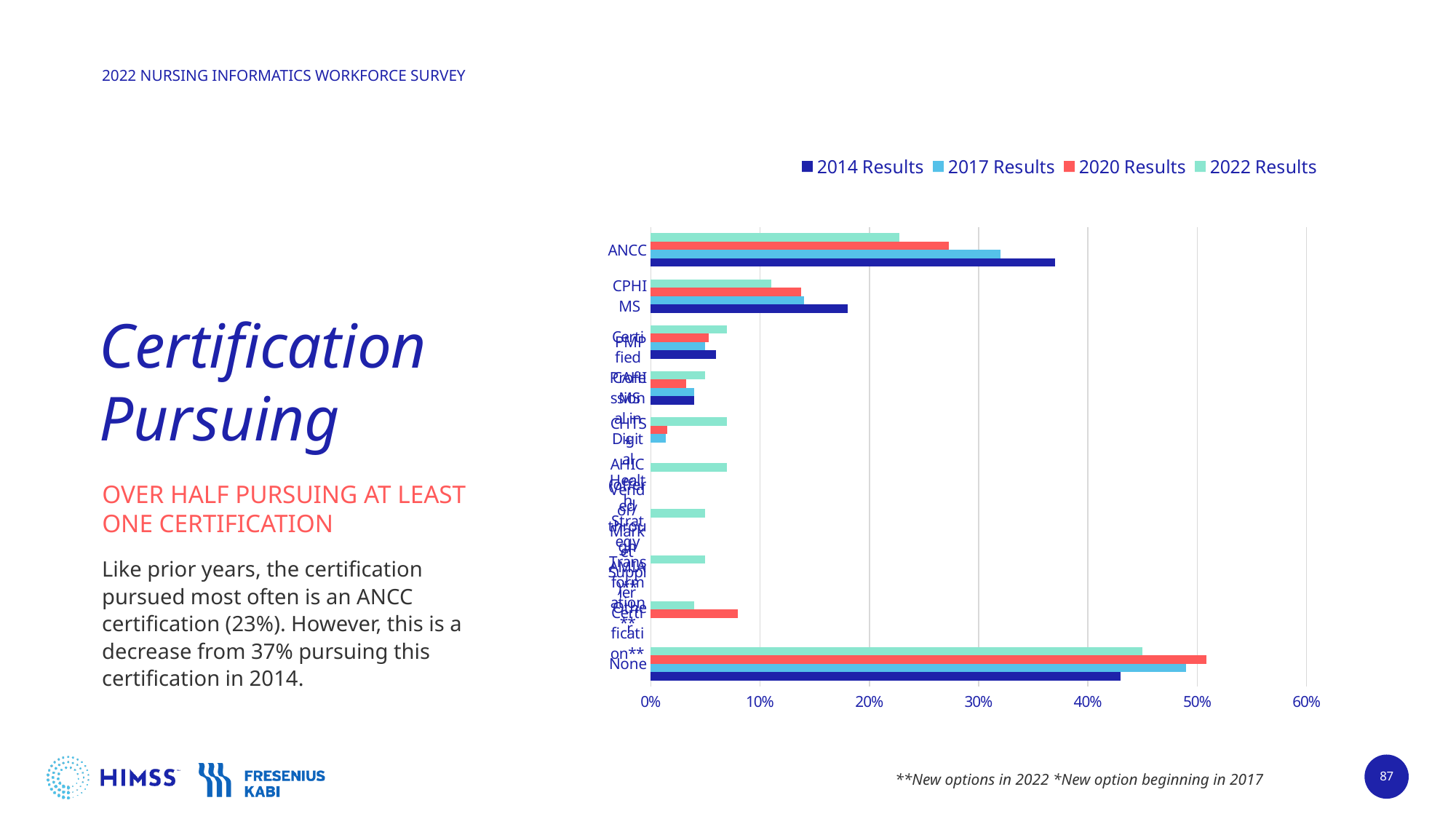
How many series does the legend list? 4 Is the 2022 Results value for ANCC greater or less than 20%? greater According to the slide text, what percentage pursued an ANCC certification in 2022? 23% Is the 2014 Results value for None greater or less than 40%? greater Is the 2014 Results value for ANCC greater or less than 30%? greater Which category has the highest 2022 Results value? None For CPHIMS, is the 2014 Results value larger or the 2022 Results value? 2014 Results For ANCC, is the 2014 Results value larger or the 2017 Results value? 2014 Results For ANCC, which series has the highest value? 2014 Results Which series does the legend list first? 2014 Results What kind of chart is shown on the slide? bar chart